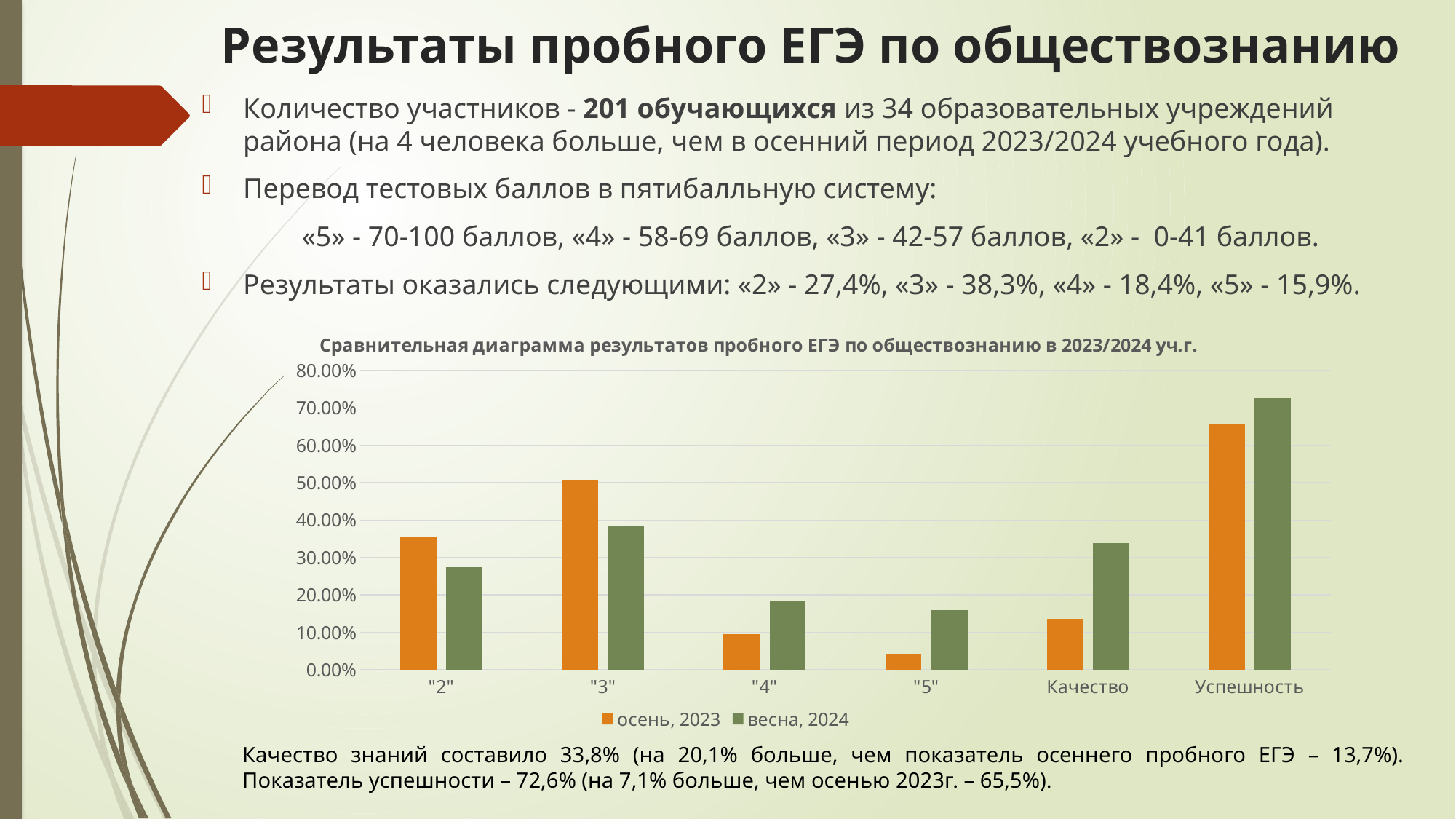
By how much does the Успешность value for "весна, 2024" exceed the value for "осень, 2023"? 7,1% How many series does the legend of the chart list? 2 What is the value for Успешность in the series "осень, 2023"? 65,5% What is the value for Качество in the series "весна, 2024"? 33,8% How many categories are shown along the x axis of the chart? 6 Is the value for "3" in the series "осень, 2023" greater or less than 40.00%? greater What kind of chart is shown on the slide? bar chart Is the value for "4" in the series "весна, 2024" greater or less than 20.00%? less Which category has the highest value for the series "весна, 2024"? Успешность What are the two legend entries of the chart? осень, 2023 and весна, 2024 Which category has the lowest value for the series "осень, 2023"? "5" For the category "2", which series has the larger value: "осень, 2023" or "весна, 2024"? осень, 2023